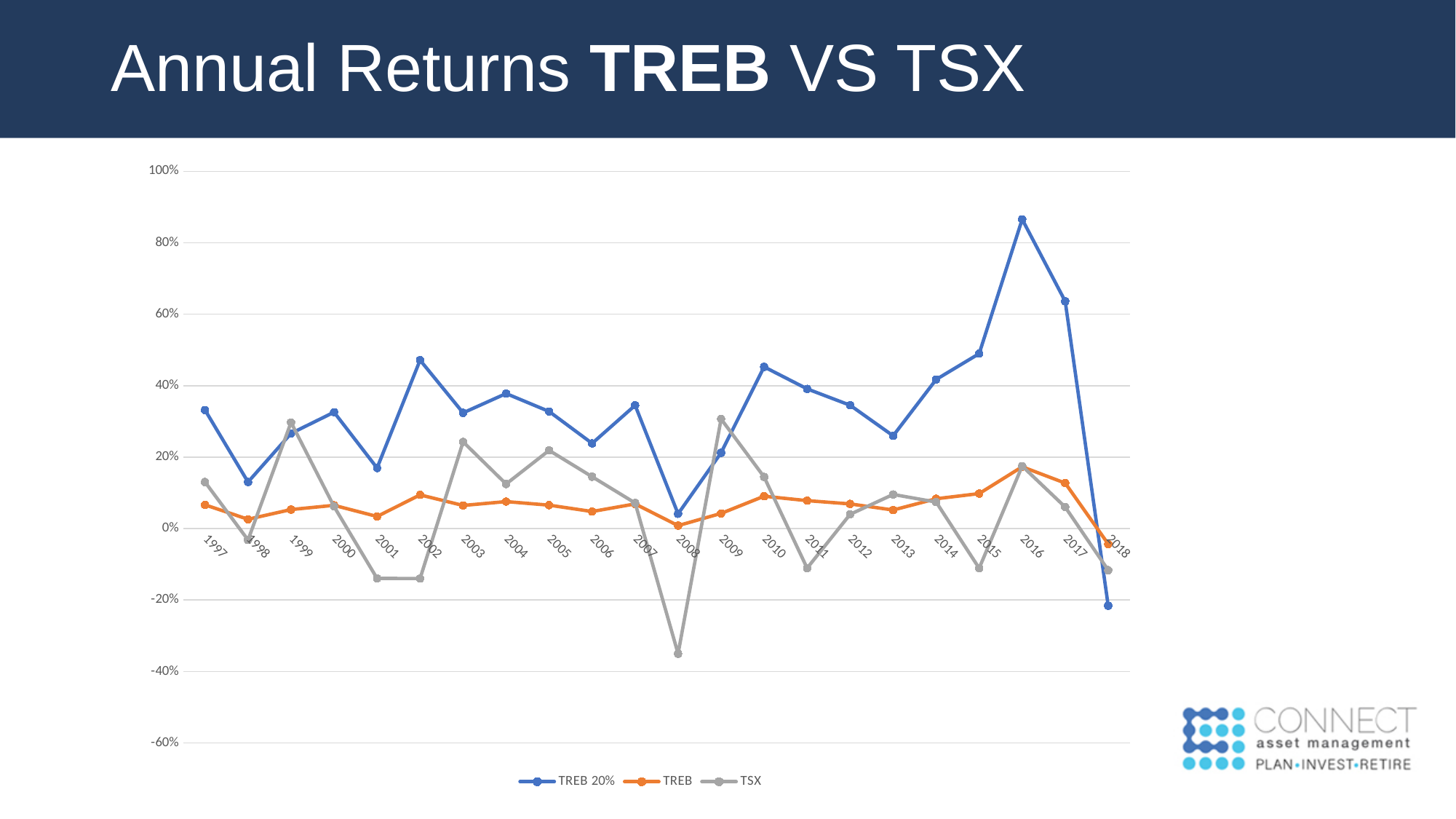
In 2008, which series has the larger value, TREB or TSX? TREB In which year does the TREB 20% series reach its lowest value? 2018 How many years are plotted along the x axis? 22 What kind of chart is shown on the slide? line chart In which year does the TREB 20% series reach its highest value? 2016 Is the value for TSX in 2008 greater or less than -20%? less Is the value for TREB 20% in 2016 greater or less than 80%? greater How many series does the legend list? 3 What are the names of the three series in the legend? TREB 20%, TREB, TSX Is the value for TREB 20% in 2002 greater or less than 40%? greater In which year does the TSX series reach its lowest value? 2008 Does the TREB 20% series rise or fall from 2013 to 2016? rise